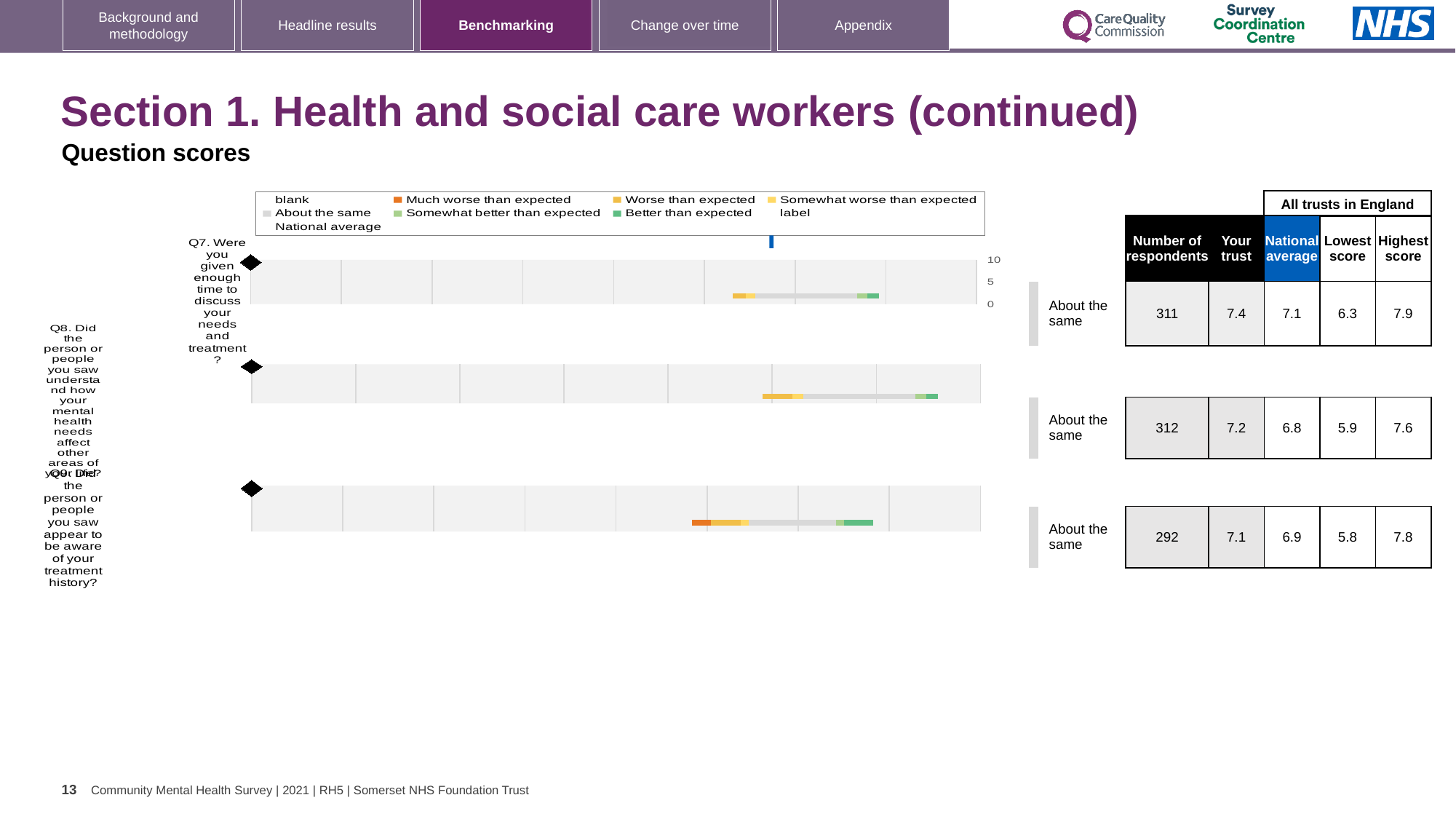
For Q9 (Did the person or people you saw appear to be aware of your treatment history?), how many respondents were there? 292 For Q9, what is the highest score among all trusts in England? 7.8 For Q7 (Were you given enough time to discuss your needs and treatment?), what is the 'Your trust' score? 7.4 What kind of chart is used to show the question scores on this slide? Bar chart What benchmark label is given to Q7's result? About the same For Q8 (Did the person or people you saw understand how your mental health needs affect other areas of your life?), what is the national average score? 6.8 For Q8, what is the lowest score among all trusts in England? 5.9 For Q8, which is larger: the 'Your trust' score or the national average? Your trust Which question has the highest 'Your trust' score? Q7 How many questions (Q7, Q8, Q9) are charted on this slide? 3 What is the maximum value shown on the score axis of the charts? 10 For Q7, what is the difference between the 'Your trust' score and the national average? 0.3